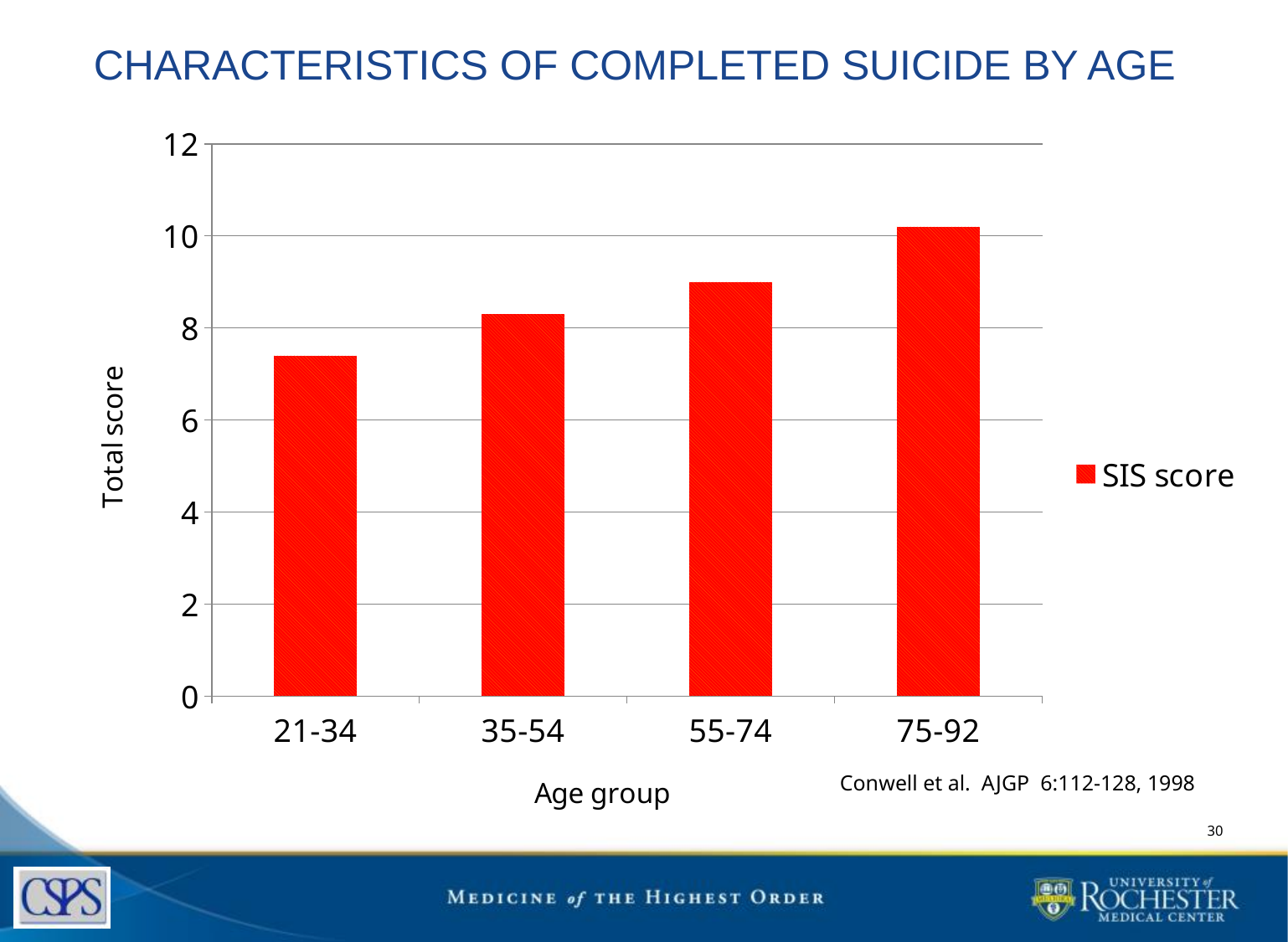
How many age groups are shown on the x axis? 4 Is the SIS score for the 55-74 age group greater or less than 10? less Which age group has the lowest SIS score? 21-34 Do the SIS scores rise or fall as age group increases along the x axis? rise Which age group has a larger SIS score, 35-54 or 55-74? 55-74 Is the SIS score for the 21-34 age group greater or less than 8? less Is the SIS score for the 21-34 age group greater or less than 6? greater What is the title of the y axis? Total score Which age group has the highest SIS score? 75-92 How many series does the legend list? 1 What kind of chart is shown on the slide? bar chart